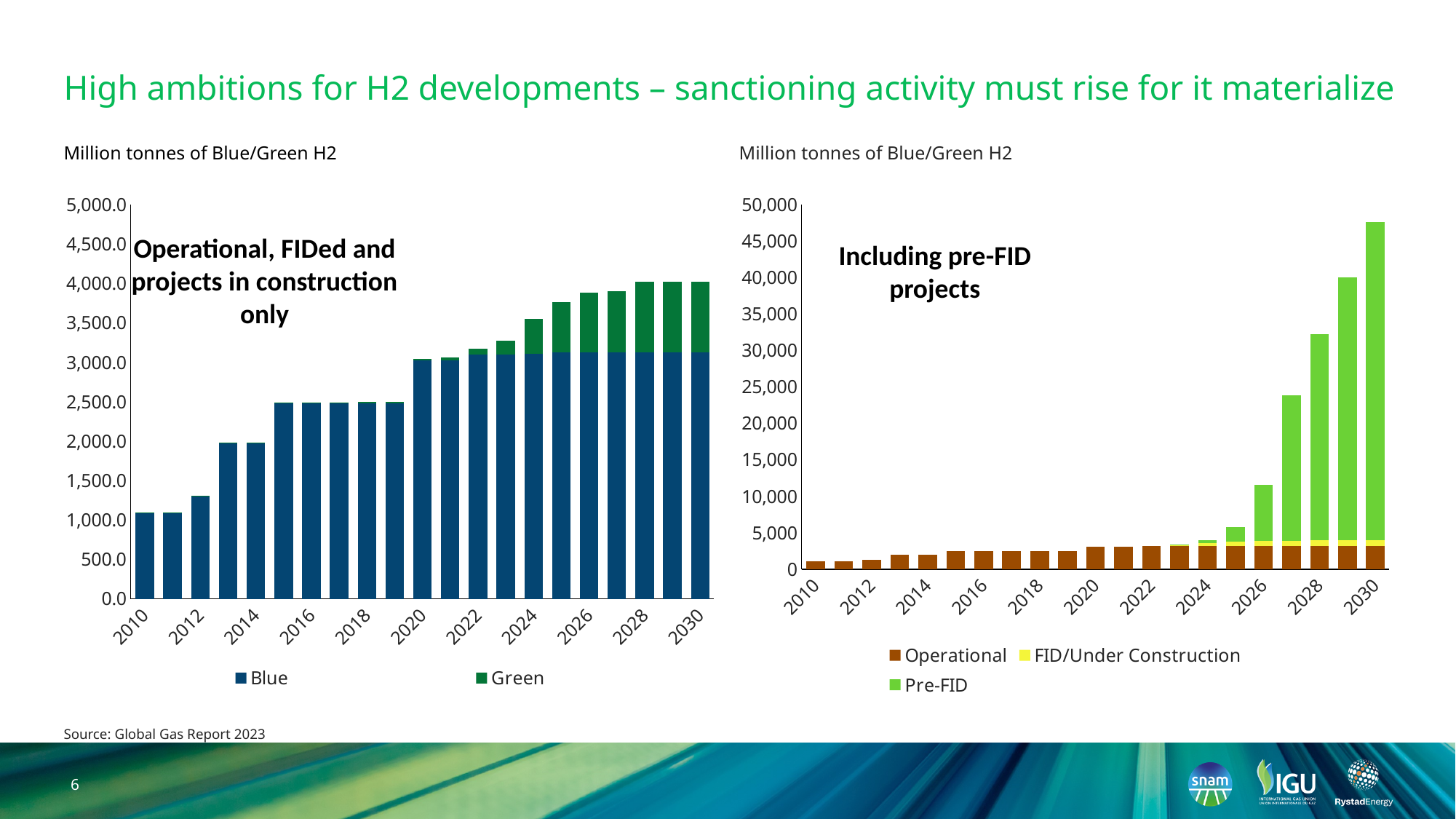
In the right chart ('Including pre-FID projects'), is the total for 2030 greater or less than 45,000? greater How many series does the legend of the left chart list? 2 How many series does the legend of the right chart ('Including pre-FID projects') list? 3 In the right chart ('Including pre-FID projects'), which year has the larger total bar, 2026 or 2028? 2028 In the right chart ('Including pre-FID projects'), is the total for 2024 greater or less than 5,000? less Which series in the right chart ('Including pre-FID projects') is shown in yellow? FID/Under Construction In the left chart ('Operational, FIDed and projects in construction only'), which year has the larger total bar, 2012 or 2016? 2016 What type of chart is the left chart titled 'Operational, FIDed and projects in construction only'? Stacked bar chart In the right chart ('Including pre-FID projects'), which year has the highest total bar? 2030 In the right chart ('Including pre-FID projects'), do the total values generally rise or fall from 2010 to 2030? rise In the left chart ('Operational, FIDed and projects in construction only'), is the total for 2030 greater or less than 3,500.0? greater